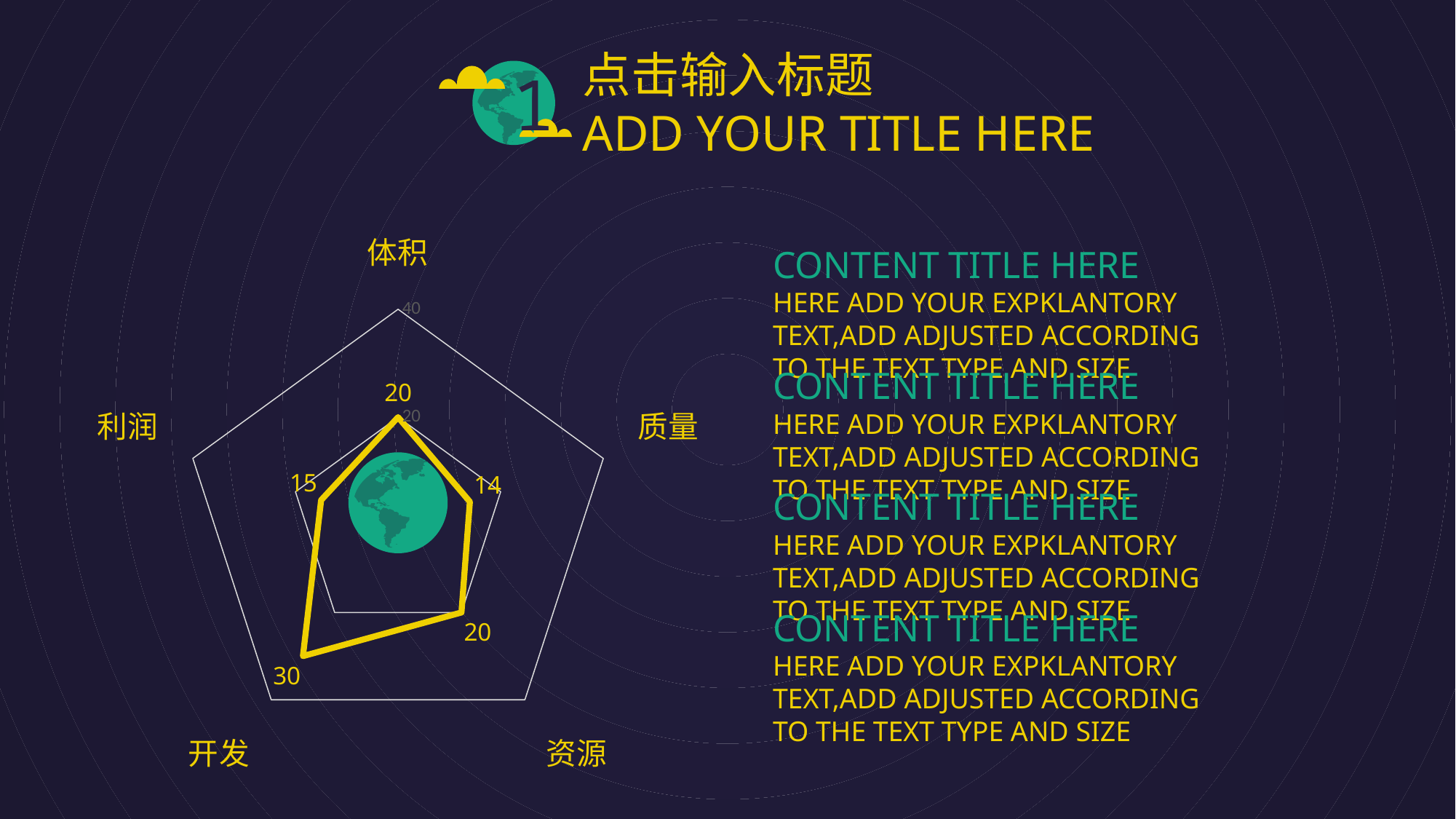
What is the value for 资源 in the radar chart? 20 Which is larger, the value for 利润 or the value for 体积? 体积 What is the value for 利润 in the radar chart? 15 What is the highest tick value shown on the radar chart's axis? 40 What is the value for 开发 in the radar chart? 30 What kind of chart is shown on the slide? radar chart What is the difference between the values for 开发 and 质量? 16 What is the value for 体积 in the radar chart? 20 Which category has the highest value in the radar chart? 开发 Which category has the lowest value in the radar chart? 质量 How many categories does the radar chart have? 5 What is the value for 质量 in the radar chart? 14